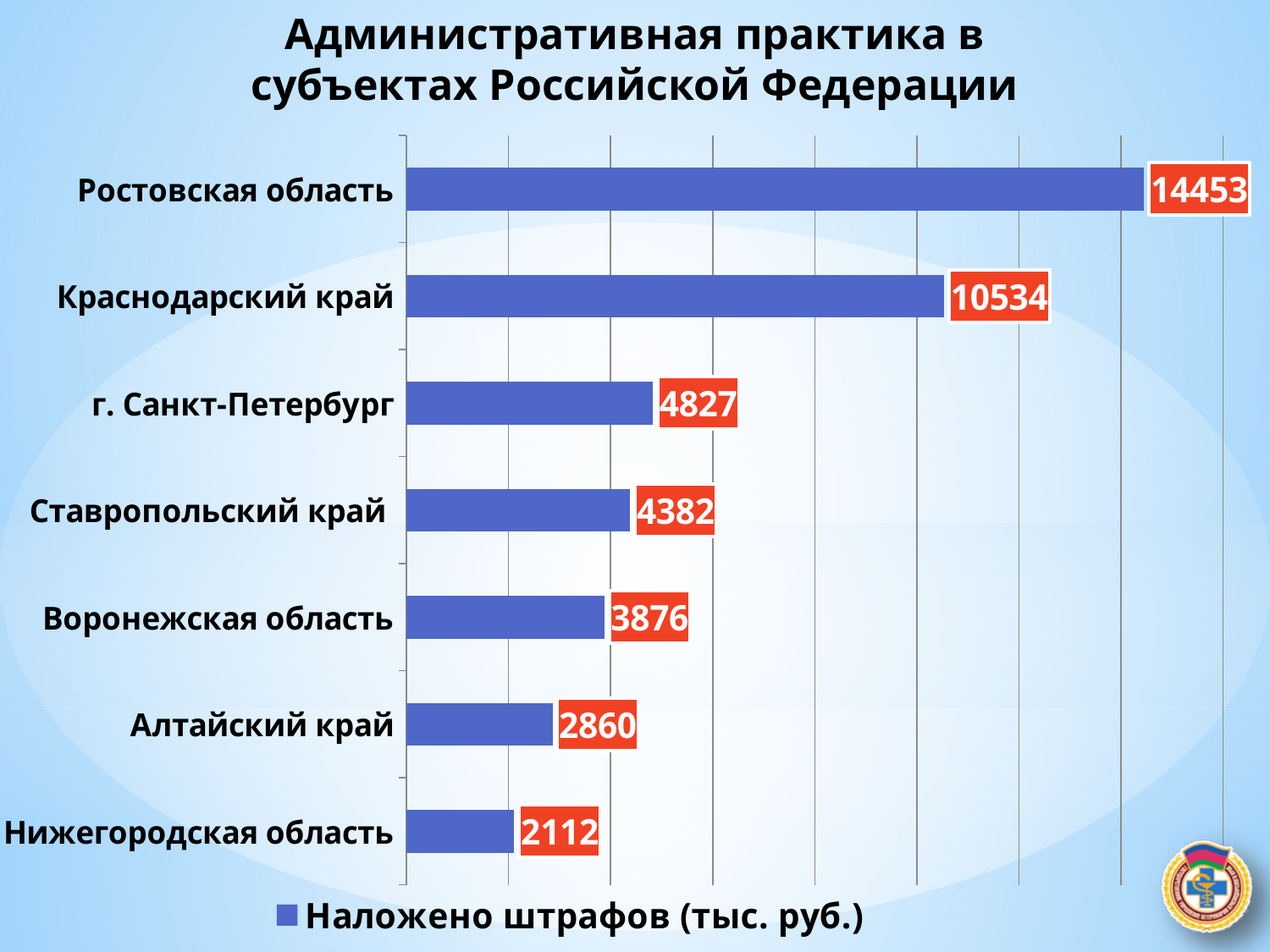
What is the difference between the values for г. Санкт-Петербург and Воронежская область? 951 What value is shown for Ростовская область? 14453 How many series does the legend list? 1 What is the difference between the values for Ростовская область and Краснодарский край? 3919 Which region has the lowest value? Нижегородская область What value is shown for Нижегородская область? 2112 What is the legend entry of the chart? Наложено штрафов (тыс. руб.) Which is larger, the value for Алтайский край or the value for Воронежская область? Воронежская область What kind of chart is shown on the slide? Bar chart What value is shown for Ставропольский край? 4382 Which region has the highest value? Ростовская область How many regions are shown in the chart? 7